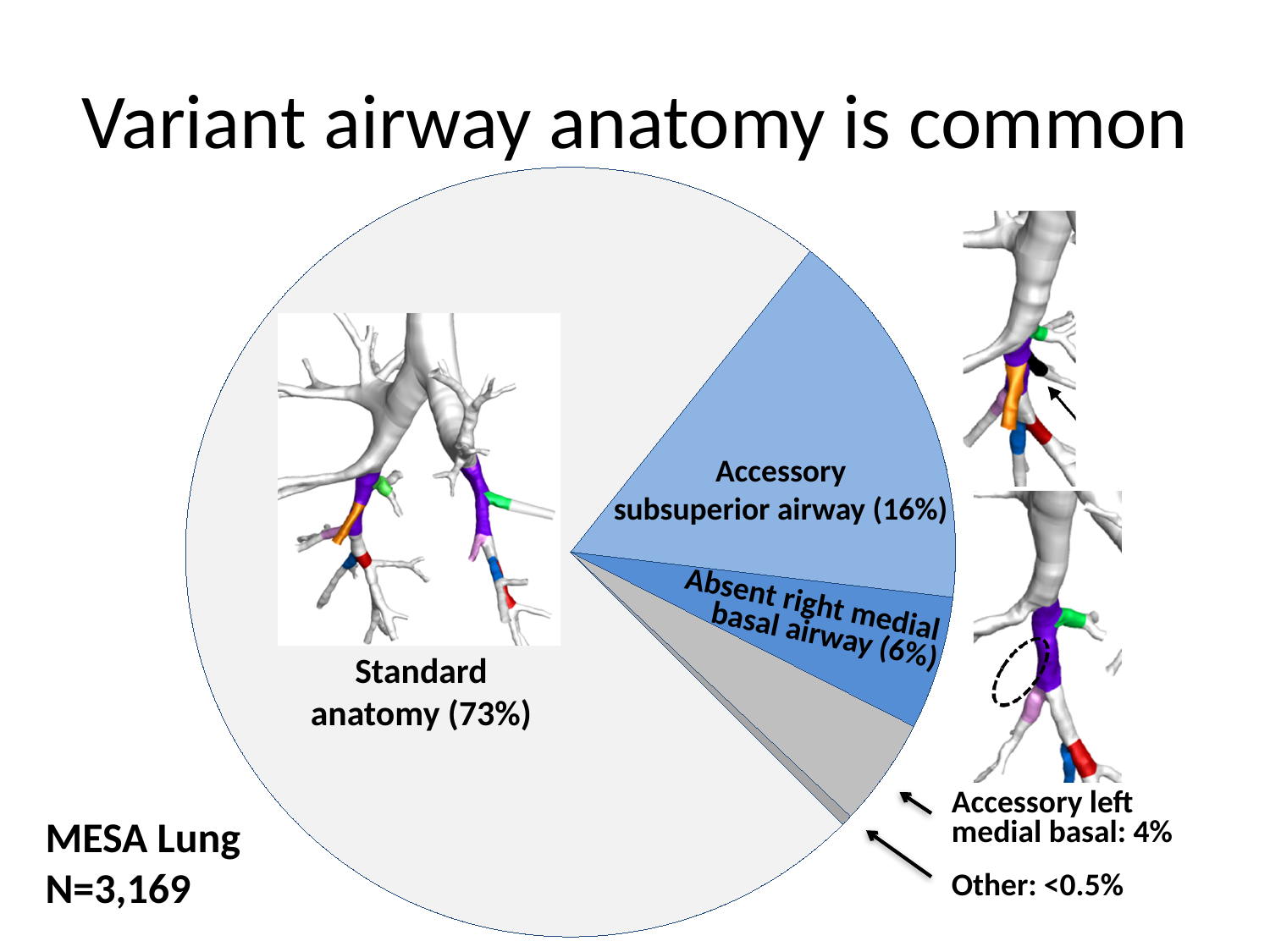
What is the difference in percentage points between Accessory subsuperior airway and Absent right medial basal airway? 10 Which category has the smallest slice of the pie? Other Which is larger, the share for Absent right medial basal airway or the share for Accessory left medial basal? Absent right medial basal airway What percentage is shown for Absent right medial basal airway? 6% What kind of chart is shown on the slide? pie chart What percentage is shown for Accessory left medial basal? 4% How many categories are shown in the pie chart? 5 What value is given for the Other category? <0.5% What is the sample size (N) stated for the MESA Lung data on the slide? N=3,169 What percentage is shown for Accessory subsuperior airway? 16% What share of the pie is labelled Standard anatomy? 73% Which category has the largest slice of the pie? Standard anatomy